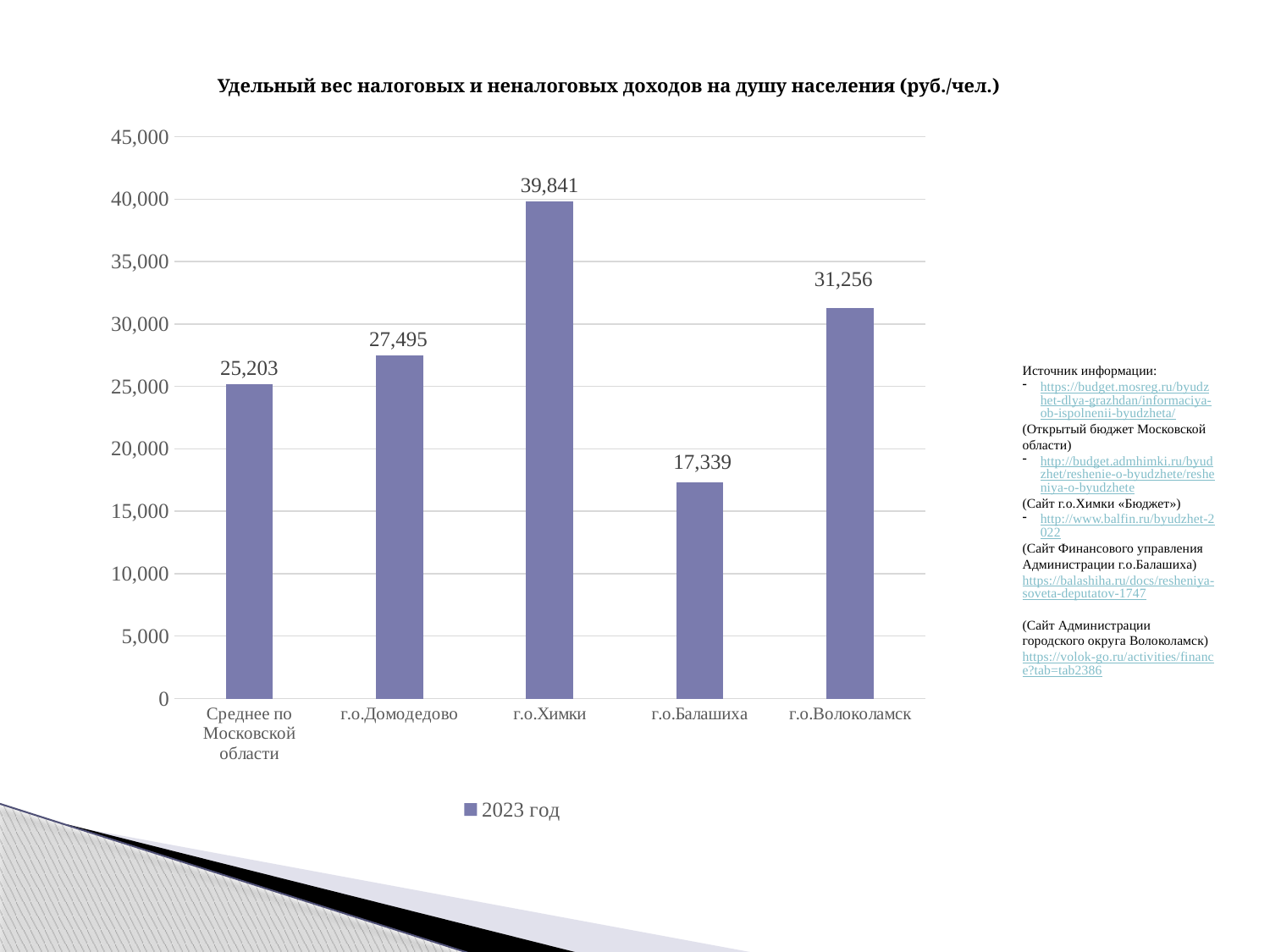
Which category has the highest value? г.о.Химки What is the value for г.о.Балашиха? 17,339 Which is larger, the value for г.о.Домодедово or the value for г.о.Волоколамск? г.о.Волоколамск What is the difference between the values for г.о.Химки and г.о.Балашиха? 22,502 Is the value for г.о.Домодедово greater or less than 30,000? less How many series does the legend list? 1 What is the value for Среднее по Московской области? 25,203 How many categories are shown on the x axis? 5 Which category has the lowest value? г.о.Балашиха What is the value for г.о.Химки? 39,841 What is the difference between the values for г.о.Волоколамск and г.о.Домодедово? 3,761 What kind of chart is shown on the slide? bar chart